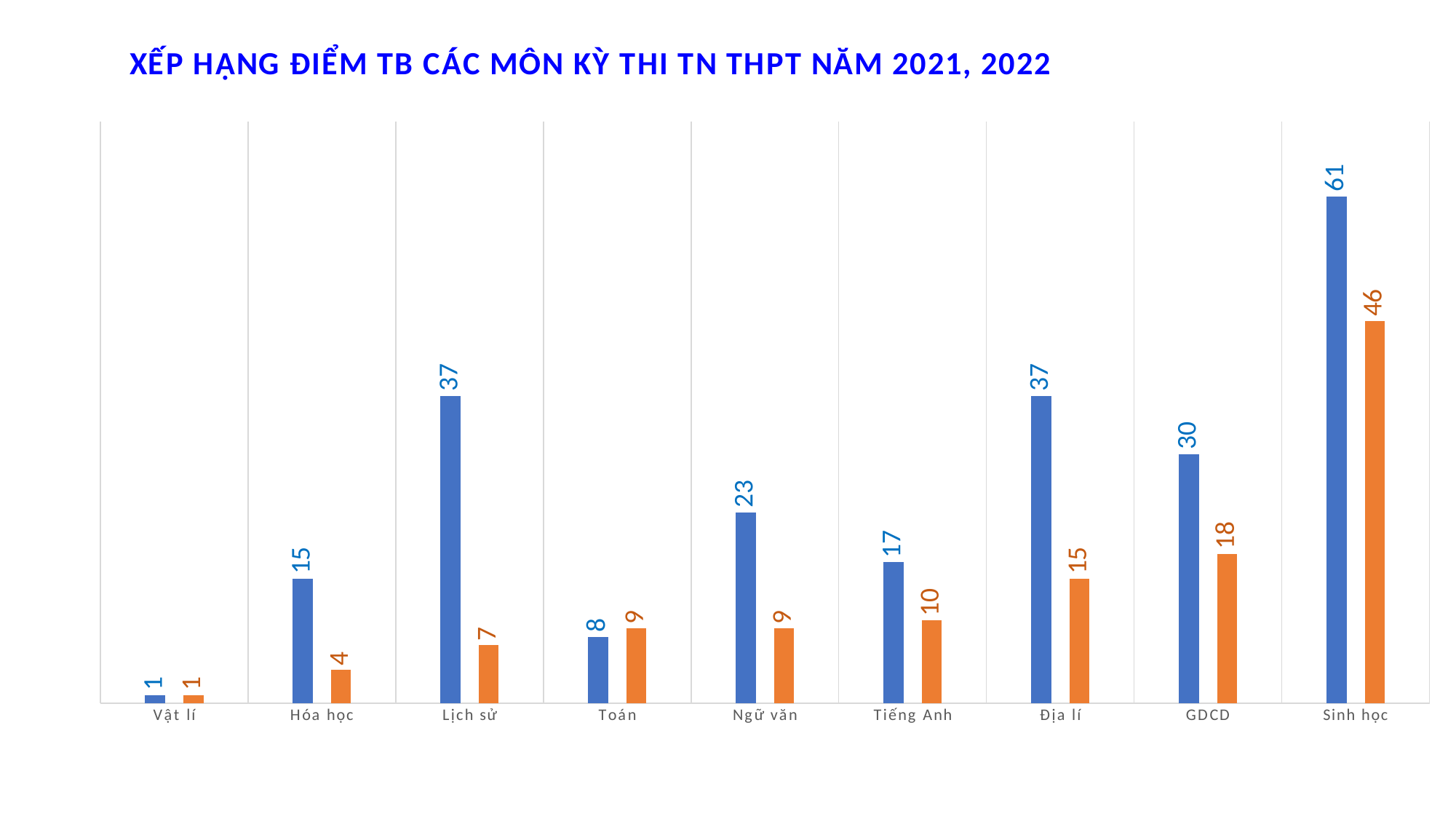
For Toán, which bar is larger, the blue or the orange? orange What is the value of the orange bar for Sinh học? 46 What is the difference between the blue bar for Sinh học and the blue bar for GDCD? 31 What is the value of the orange bar for GDCD? 18 What is the difference between the blue and orange bars for Hóa học? 11 What is the title of the chart? XẾP HẠNG ĐIỂM TB CÁC MÔN KỲ THI TN THPT NĂM 2021, 2022 What kind of chart is shown on the slide? bar chart How many categories are shown on the x axis? 9 What is the value of the blue bar for Lịch sử? 37 What is the value of the blue bar for Ngữ văn? 23 Which category has the highest blue bar? Sinh học Which category has the lowest orange bar? Vật lí